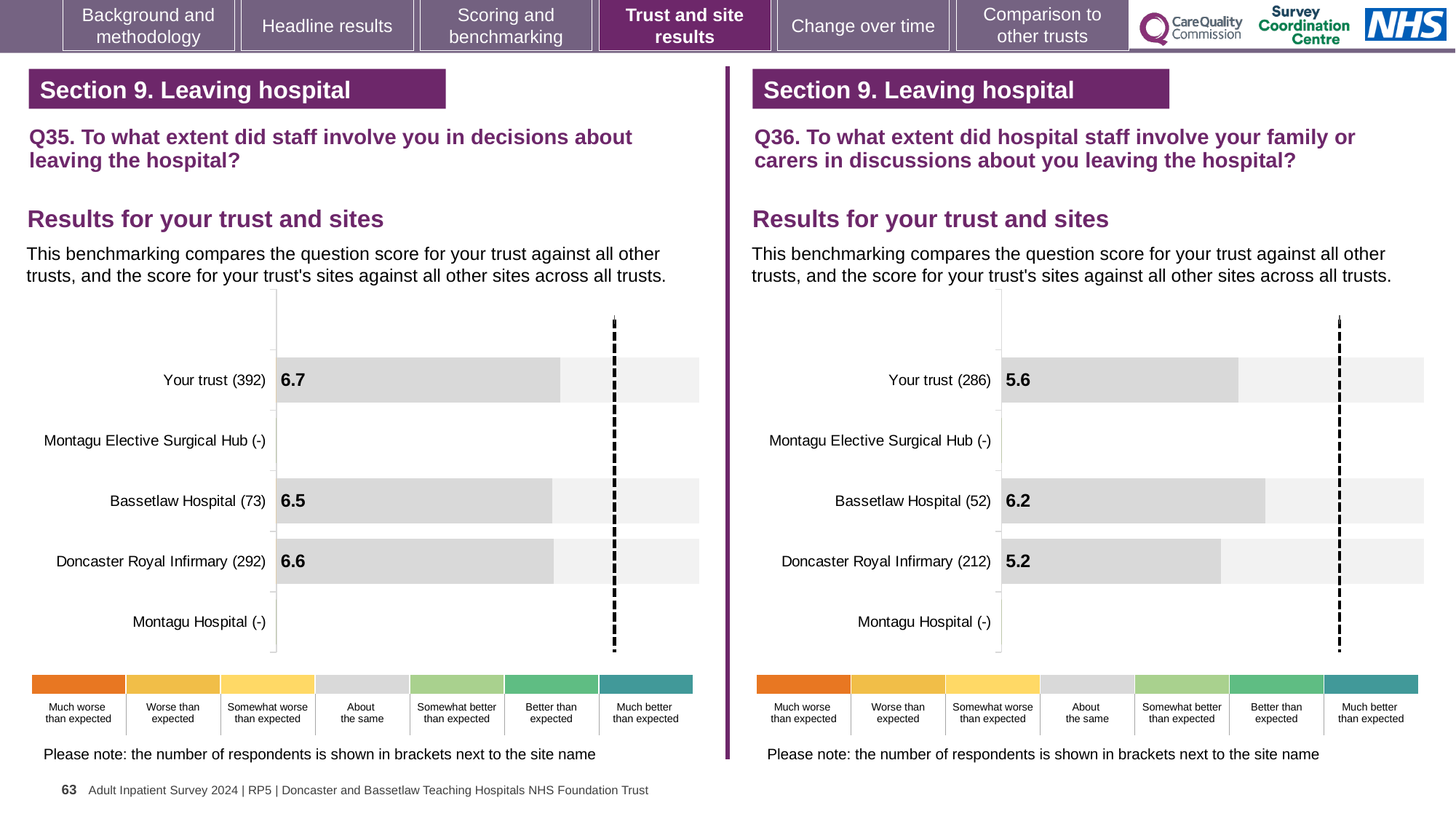
In the Q36 chart on the right, which row has the highest score? Bassetlaw Hospital In the Q36 chart on the right, which row has the lowest score among those with a value shown? Doncaster Royal Infirmary In the Q35 chart on the left, what is the score for Bassetlaw Hospital? 6.5 In the Q35 chart on the left, which site or trust row has the highest score? Your trust In the Q36 chart on the right, what is the score for Doncaster Royal Infirmary? 5.2 In the Q36 chart on the right, what is the difference between the scores for Bassetlaw Hospital and Doncaster Royal Infirmary? 1.0 In the Q35 chart on the left, what is the score for Your trust? 6.7 In the Q35 chart on the left, how many respondents are shown for Doncaster Royal Infirmary? 292 What type of chart is used for the Q35 results on the left? Bar chart In the Q36 chart on the right, what is the score for Your trust? 5.6 In the Q36 chart on the right, how many rows (trust and sites) are listed on the vertical axis? 5 In the Q35 chart on the left, what is the difference between the scores for Your trust and Bassetlaw Hospital? 0.2